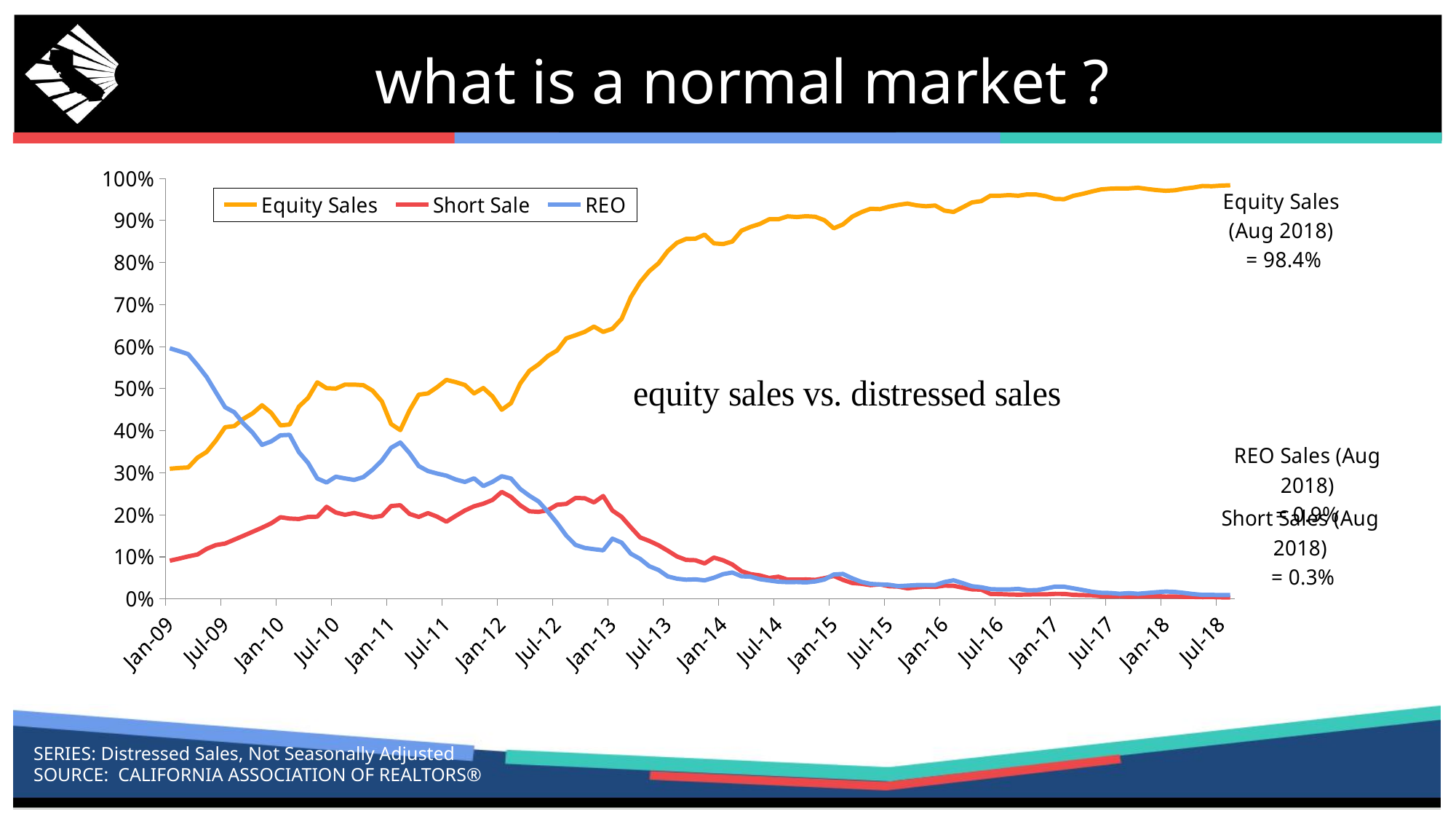
At Jan-09, which series has the higher value, REO or Equity Sales? REO Is the Equity Sales value at Jul-13 greater or less than 80%? greater What is the Short Sales value for Aug 2018 according to the annotation? 0.3% Is the Equity Sales value at Jan-09 greater or less than 40%? less How many series does the legend list? 3 Is the REO value at Jan-09 greater or less than 50%? greater Does the Equity Sales line rise or fall overall from Jan-09 to Jul-18? rise Which series has the highest value at Jul-18? Equity Sales What is the difference between the Equity Sales and Short Sales values for Aug 2018? 98.1% What kind of chart is shown on the slide? line chart What is the Equity Sales value for Aug 2018 according to the annotation? 98.4% Does the REO line rise or fall overall from Jan-09 to Jul-18? fall